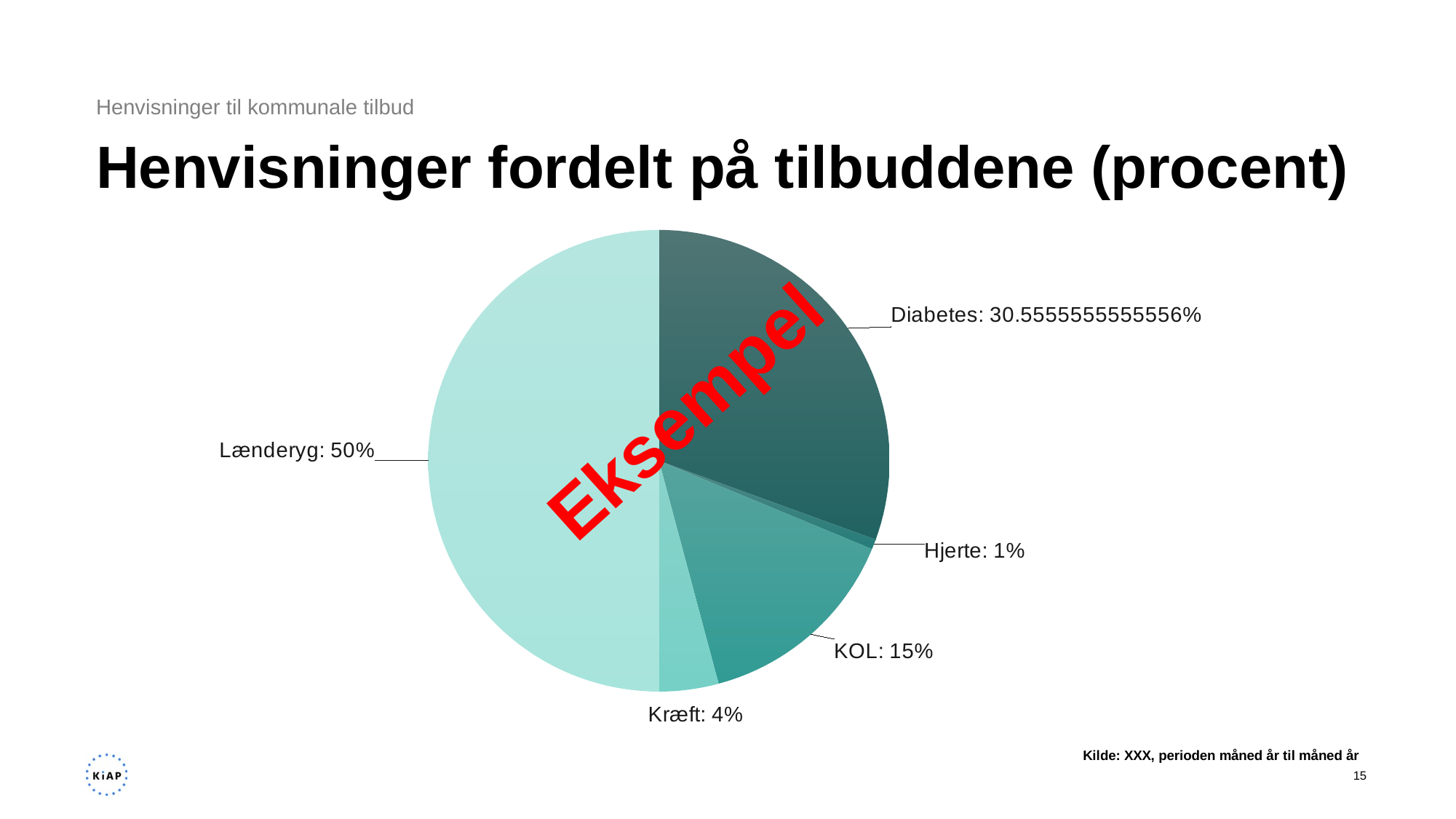
How many categories are shown in the pie chart? 5 What is the difference between the values for KOL and Kræft? 11% Which category has the largest slice? Lænderyg What is the value for Lænderyg? 50% What is the value for Hjerte? 1% What kind of chart is shown on the slide? pie chart Which is larger, KOL or Kræft? KOL What is the title of the chart on the slide? Henvisninger fordelt på tilbuddene (procent) Which category has the smallest slice? Hjerte What is the value for Diabetes? 30.5555555555556% What is the value for KOL? 15% What is the value for Kræft? 4%